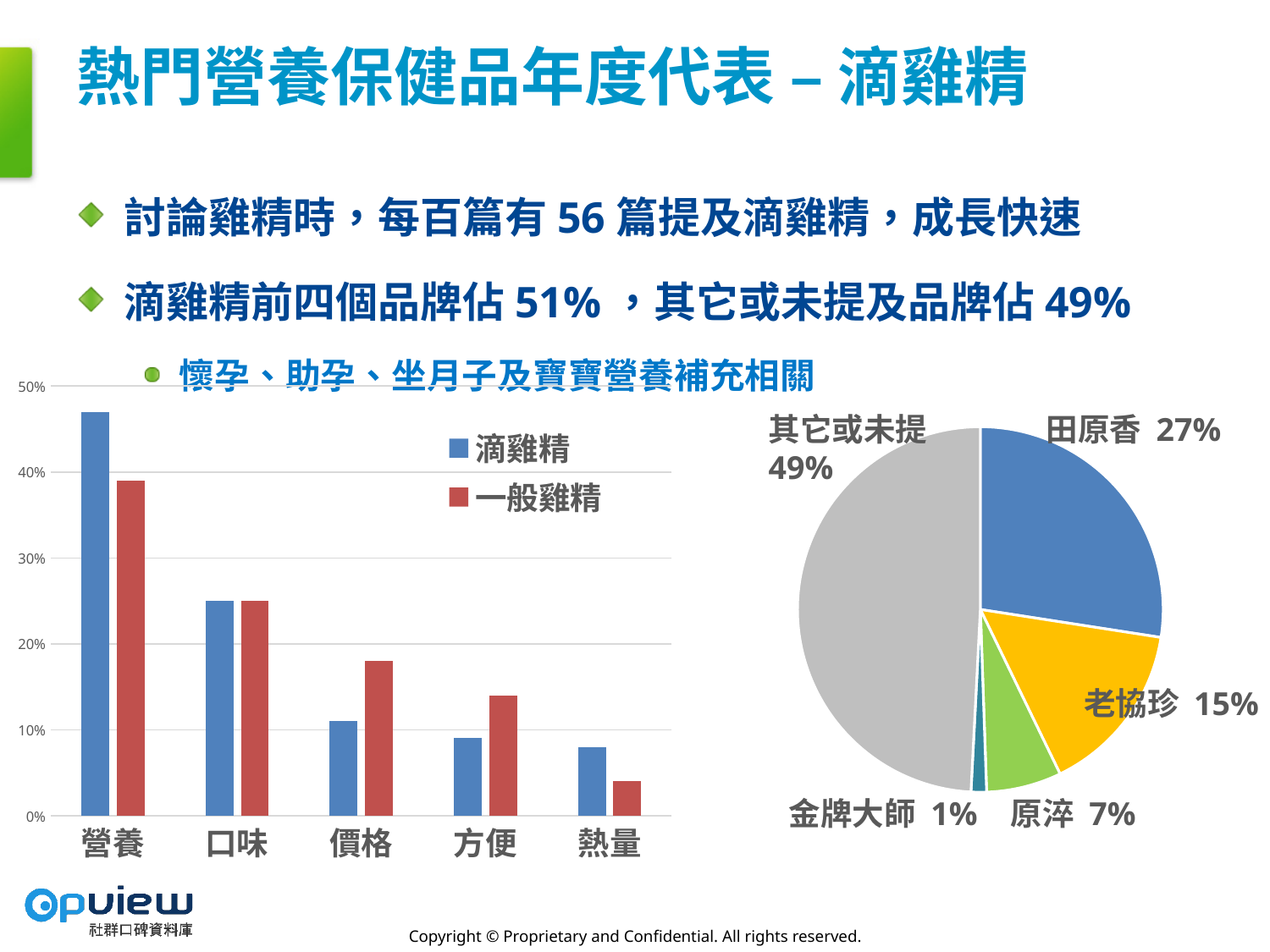
What kind of chart is the chart on the left of the slide? bar chart How many categories are shown on the x axis of the bar chart on the left? 5 In the bar chart on the left, which category has the highest value for 滴雞精? 營養 In the bar chart on the left, for 價格, which series has the larger value, 滴雞精 or 一般雞精? 一般雞精 In the bar chart on the left, is the 滴雞精 value for 營養 greater or less than 40%? greater In the pie chart on the right, which named brand has the smallest share? 金牌大師 In the bar chart on the left, do the 滴雞精 values rise or fall from 營養 to 熱量? fall In the bar chart on the left, which category has the lowest value for 一般雞精? 熱量 How many series does the legend of the bar chart on the left list? 2 In the bar chart on the left, is the 一般雞精 value for 價格 greater or less than 20%? less In the pie chart on the right, what share does 田原香 have? 27% In the pie chart on the right, what is the difference between the shares of 老協珍 and 原淬? 8%